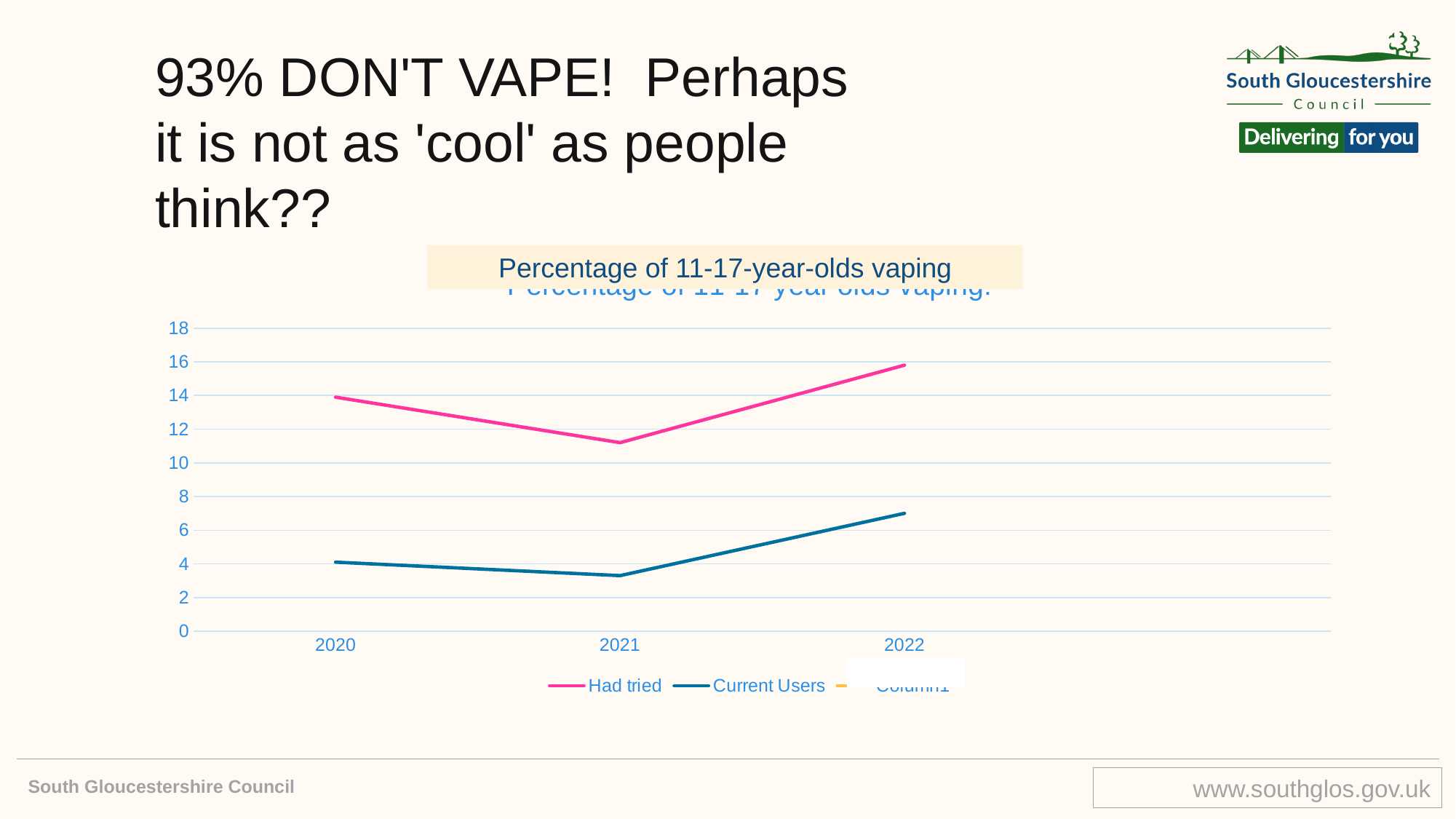
Is the 'Had tried' value for 2022 greater or less than 14? greater Is the 'Current Users' value for 2022 greater or less than 6? greater How many years are shown on the x axis of the chart? 3 In which year is the 'Current Users' line at its highest? 2022 In which year is the 'Had tried' line at its highest? 2022 Is the 'Current Users' value for 2021 greater or less than 4? less In 2020, which series has the larger value, 'Had tried' or 'Current Users'? Had tried In which year is the 'Had tried' line at its lowest? 2021 Does the 'Current Users' line rise or fall from 2021 to 2022? Rise What is the title of the chart? Percentage of 11-17-year-olds vaping What kind of chart is shown on the slide? Line chart